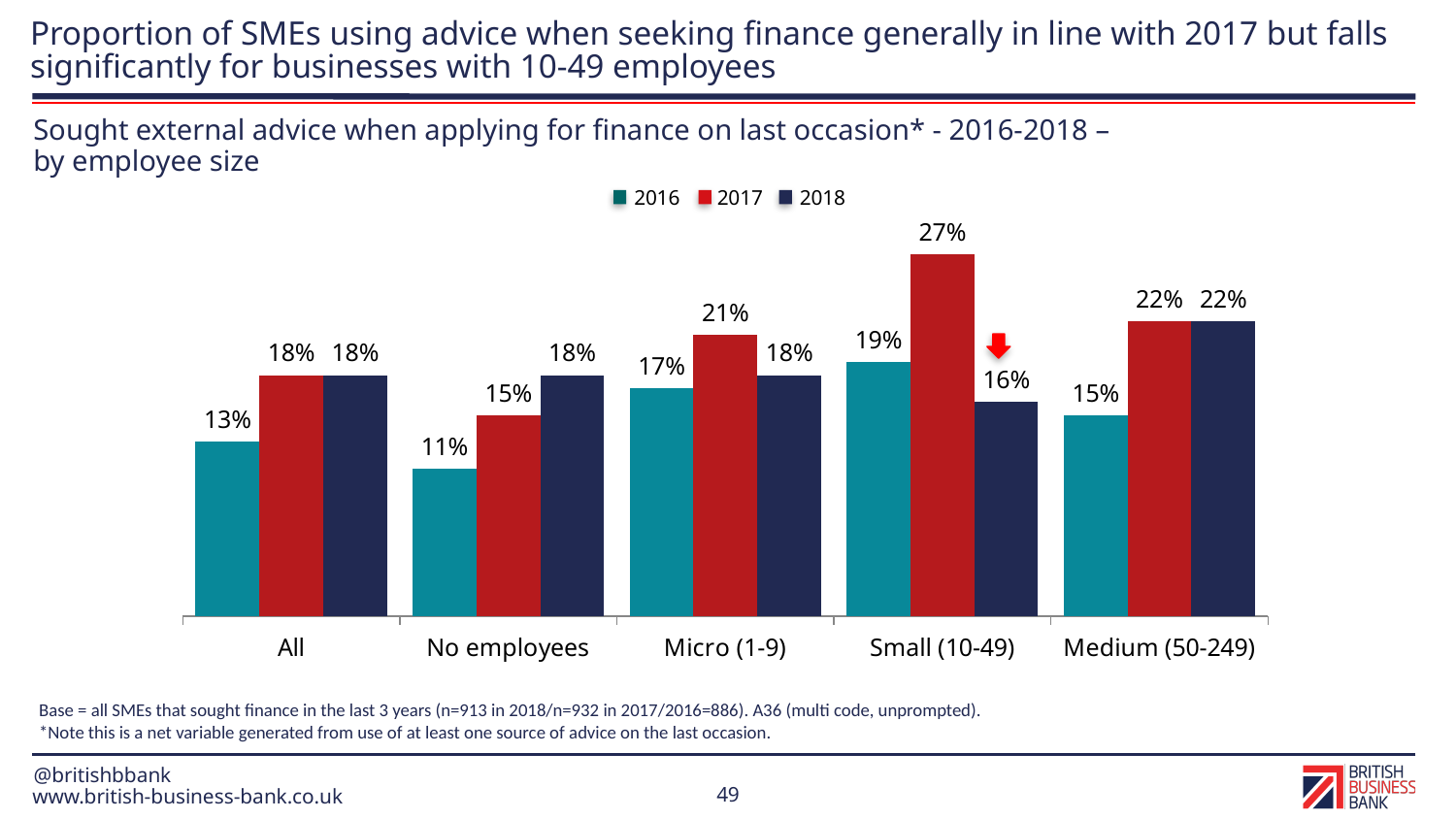
What was the value for Medium (50-249) in 2018? 22% How many employee size categories are shown on the x axis? 5 How many series does the legend list? 3 What kind of chart is shown on the slide? Bar chart Which employee size category had the highest value in 2017? Small (10-49) Which years are listed in the chart legend? 2016, 2017, 2018 What was the value for No employees in 2016? 11% Which is larger for Micro (1-9): the 2017 value or the 2018 value? 2017 What was the value for Small (10-49) in 2017? 27% What is the difference between the 2017 and 2018 values for Small (10-49)? 11 percentage points Which employee size category had the lowest value in 2016? No employees Did the value for All rise or fall from 2016 to 2017? Rise